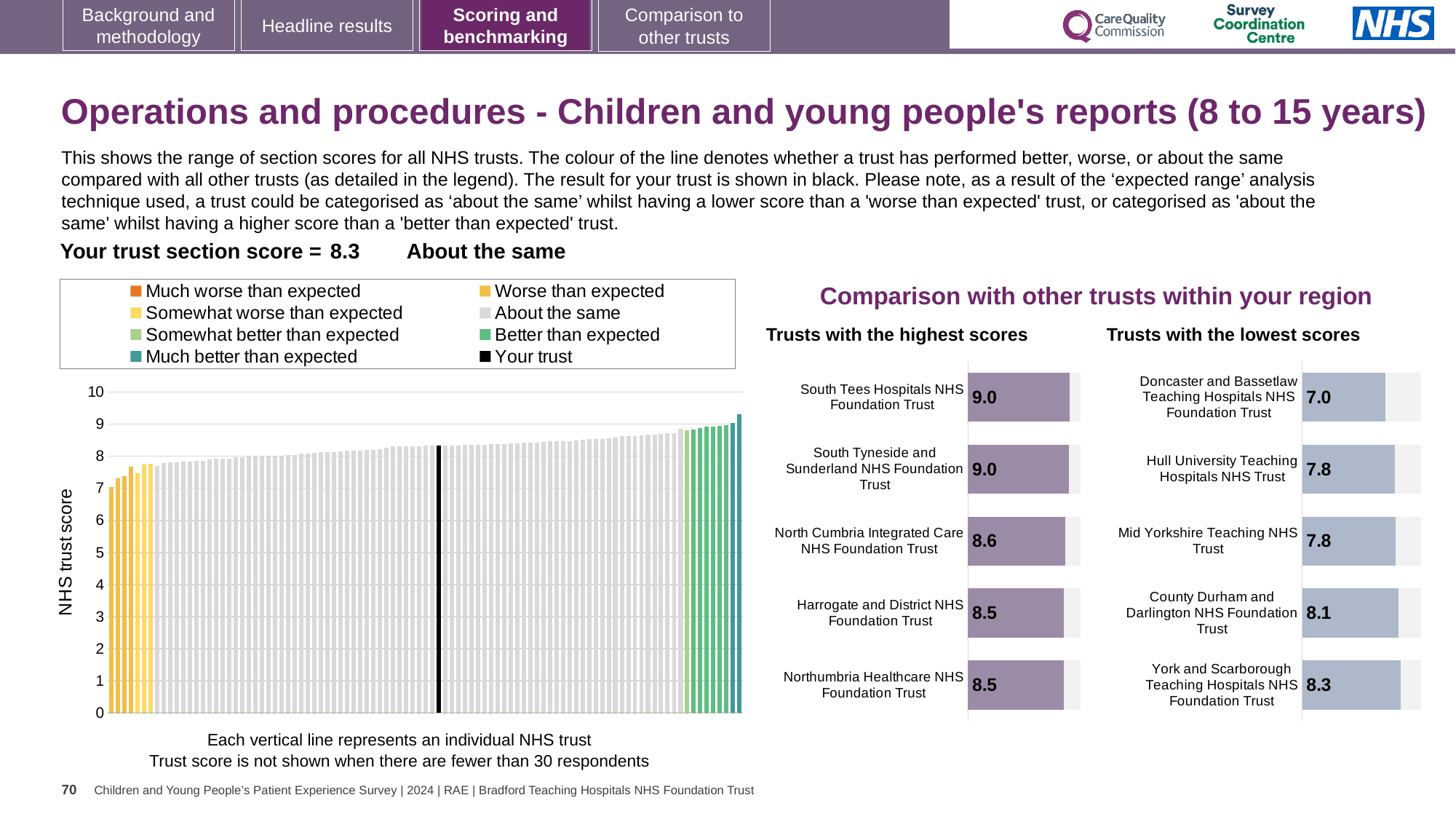
What kind of chart is the large chart on the left showing all NHS trusts? Bar chart In the 'Trusts with the lowest scores' chart, what is the score for County Durham and Darlington NHS Foundation Trust? 8.1 In the 'Trusts with the highest scores' chart, what is the score for North Cumbria Integrated Care NHS Foundation Trust? 8.6 In the 'Trusts with the highest scores' chart, how many trusts are shown? 5 In the large chart on the left showing all NHS trusts, is the value of the tallest bar greater or less than 9? greater In the 'Trusts with the lowest scores' chart, what is the difference between the scores of York and Scarborough Teaching Hospitals NHS Foundation Trust and Doncaster and Bassetlaw Teaching Hospitals NHS Foundation Trust? 1.3 In the 'Trusts with the lowest scores' chart, which trust has the highest score? York and Scarborough Teaching Hospitals NHS Foundation Trust In the 'Trusts with the highest scores' chart, what is the score for South Tees Hospitals NHS Foundation Trust? 9.0 In the 'Trusts with the lowest scores' chart, which trust has the lowest score? Doncaster and Bassetlaw Teaching Hospitals NHS Foundation Trust In the large chart on the left showing all NHS trusts, what is the section score for your trust (the black bar)? 8.3 In the 'Trusts with the highest scores' chart, what is the difference between the scores of South Tees Hospitals NHS Foundation Trust and Harrogate and District NHS Foundation Trust? 0.5 In the 'Trusts with the lowest scores' chart, which has the higher score: Hull University Teaching Hospitals NHS Trust or County Durham and Darlington NHS Foundation Trust? County Durham and Darlington NHS Foundation Trust